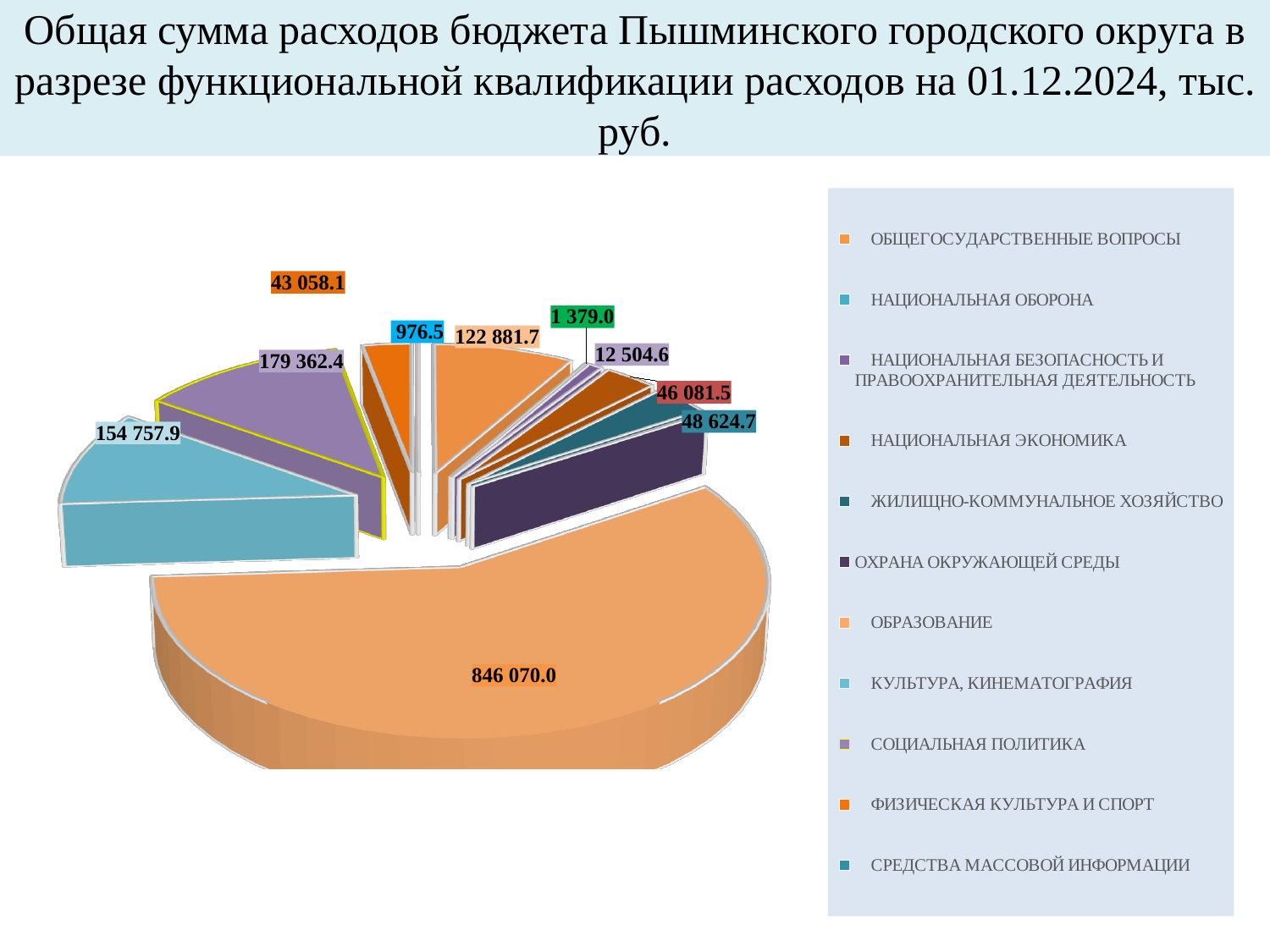
As of what date does the chart title say the expenditure data is given? 01.12.2024 How many entries does the legend of the pie chart list? 11 How many data labels are printed on the pie chart? 10 Which is larger: the slice labelled 122 881.7 or the slice labelled 154 757.9? 154 757.9 What is the largest value labelled on the pie chart? 846 070.0 What type of chart is shown on the slide? pie chart What is the smallest value labelled on the pie chart? 976.5 Which is larger: the slice labelled 43 058.1 or the slice labelled 12 504.6? 43 058.1 What is the difference between the slice labelled 179 362.4 and the slice labelled 154 757.9? 24 604.5 Which category does the largest slice of the pie chart belong to? ОБРАЗОВАНИЕ What is the difference between the slice labelled 48 624.7 and the slice labelled 46 081.5? 2 543.2 What unit of measurement is stated in the chart title? тыс. руб.